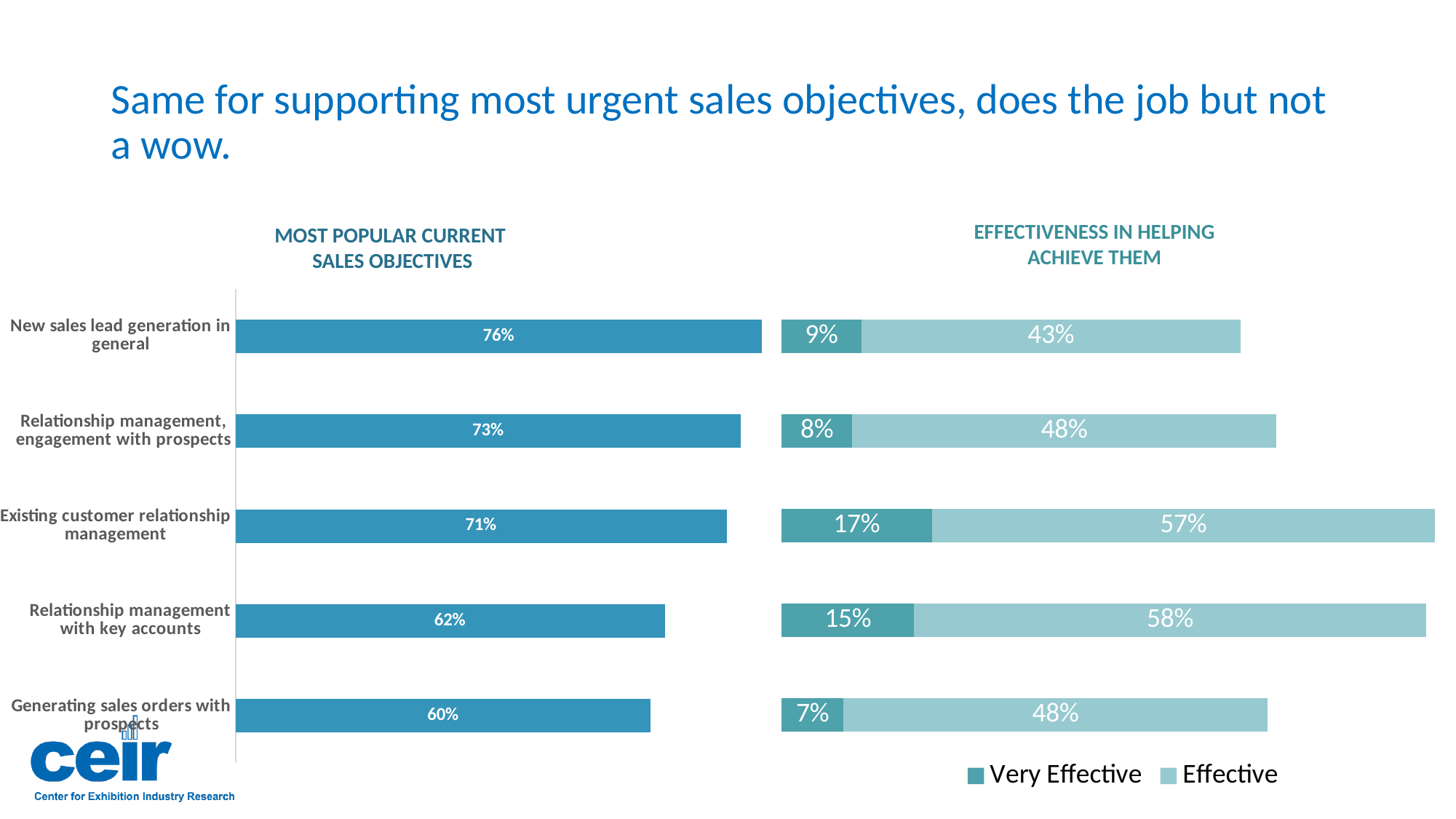
How many categories are shown in the 'Most Popular Current Sales Objectives' chart? 5 In the 'Most Popular Current Sales Objectives' chart, what is the difference between 'Relationship management, engagement with prospects' and 'Relationship management with key accounts'? 11% In the 'Effectiveness in Helping Achieve Them' chart, what is the 'Effective' value for 'Relationship management with key accounts'? 58% In the 'Most Popular Current Sales Objectives' chart, what is the value for 'New sales lead generation in general'? 76% How many series does the legend of the 'Effectiveness in Helping Achieve Them' chart list? 2 In the 'Most Popular Current Sales Objectives' chart, which category has the lowest value? Generating sales orders with prospects In the 'Effectiveness in Helping Achieve Them' chart, is the 'Effective' value larger for 'Relationship management, engagement with prospects' or for 'New sales lead generation in general'? Relationship management, engagement with prospects In the 'Effectiveness in Helping Achieve Them' chart, what is the combined total of 'Very Effective' and 'Effective' for 'Existing customer relationship management'? 74% In the 'Effectiveness in Helping Achieve Them' chart, what is the combined total of 'Very Effective' and 'Effective' for 'New sales lead generation in general'? 52% In the 'Effectiveness in Helping Achieve Them' chart, what is the 'Very Effective' value for 'Existing customer relationship management'? 17% What kind of chart is the 'Effectiveness in Helping Achieve Them' chart? Stacked bar chart In the 'Effectiveness in Helping Achieve Them' chart, which category has the lowest 'Very Effective' value? Generating sales orders with prospects